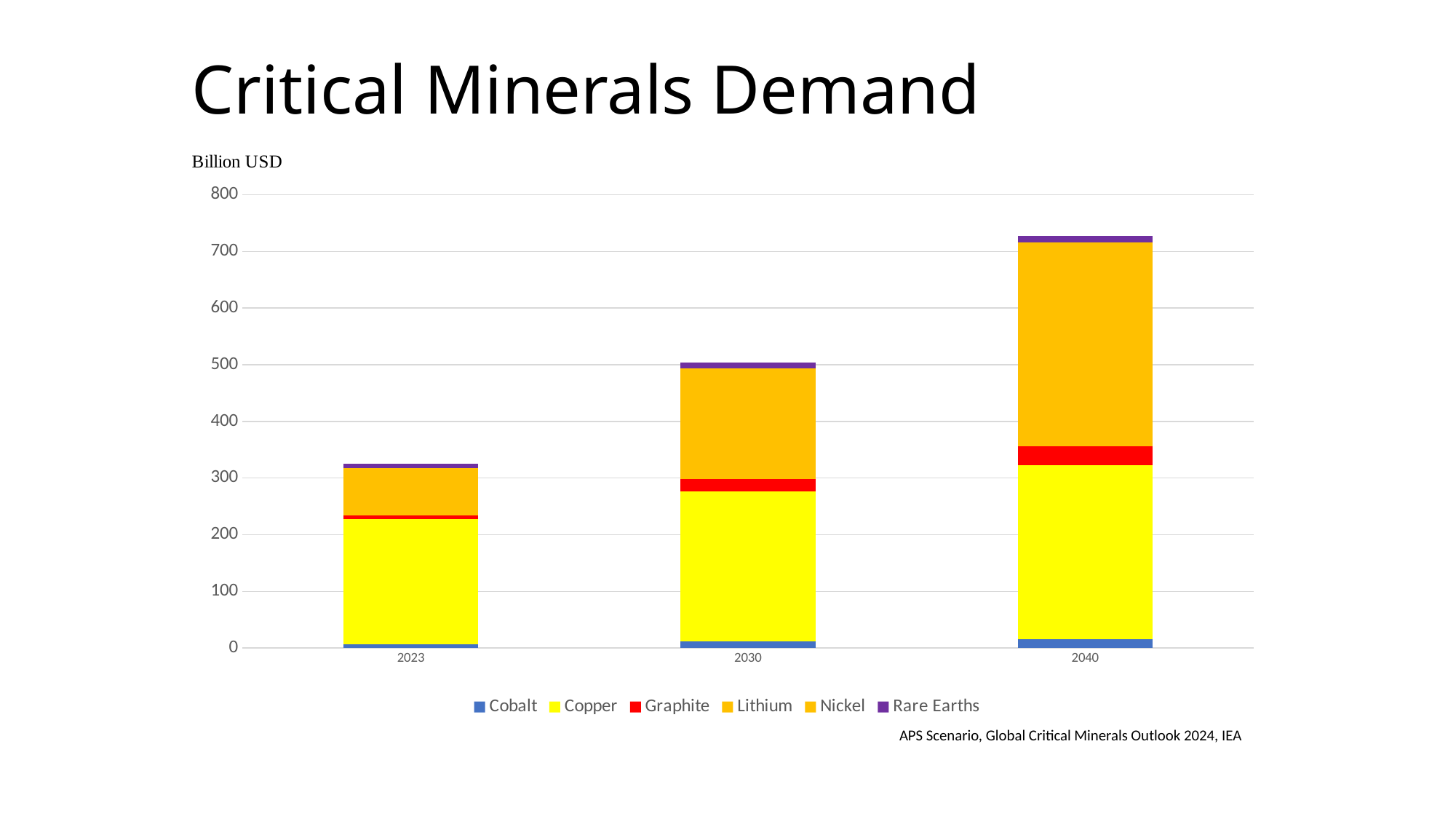
Which year has the lowest total demand in the chart? 2023 Is the total value for 2023 greater or less than 400? less Do the total bar heights rise or fall from 2023 to 2040? rise Is the total value for 2030 greater or less than 600? less Which series is shown in yellow in the chart's legend? Copper How many series does the chart's legend list? 6 Which year has the highest total demand in the chart? 2040 Is the total value for 2040 greater or less than 700? greater Is the total bar for 2030 taller than the total bar for 2023? yes What kind of chart is shown on the slide? stacked bar chart How many years are shown on the x axis of the chart? 3 What unit is given for the values on the chart's y axis? Billion USD